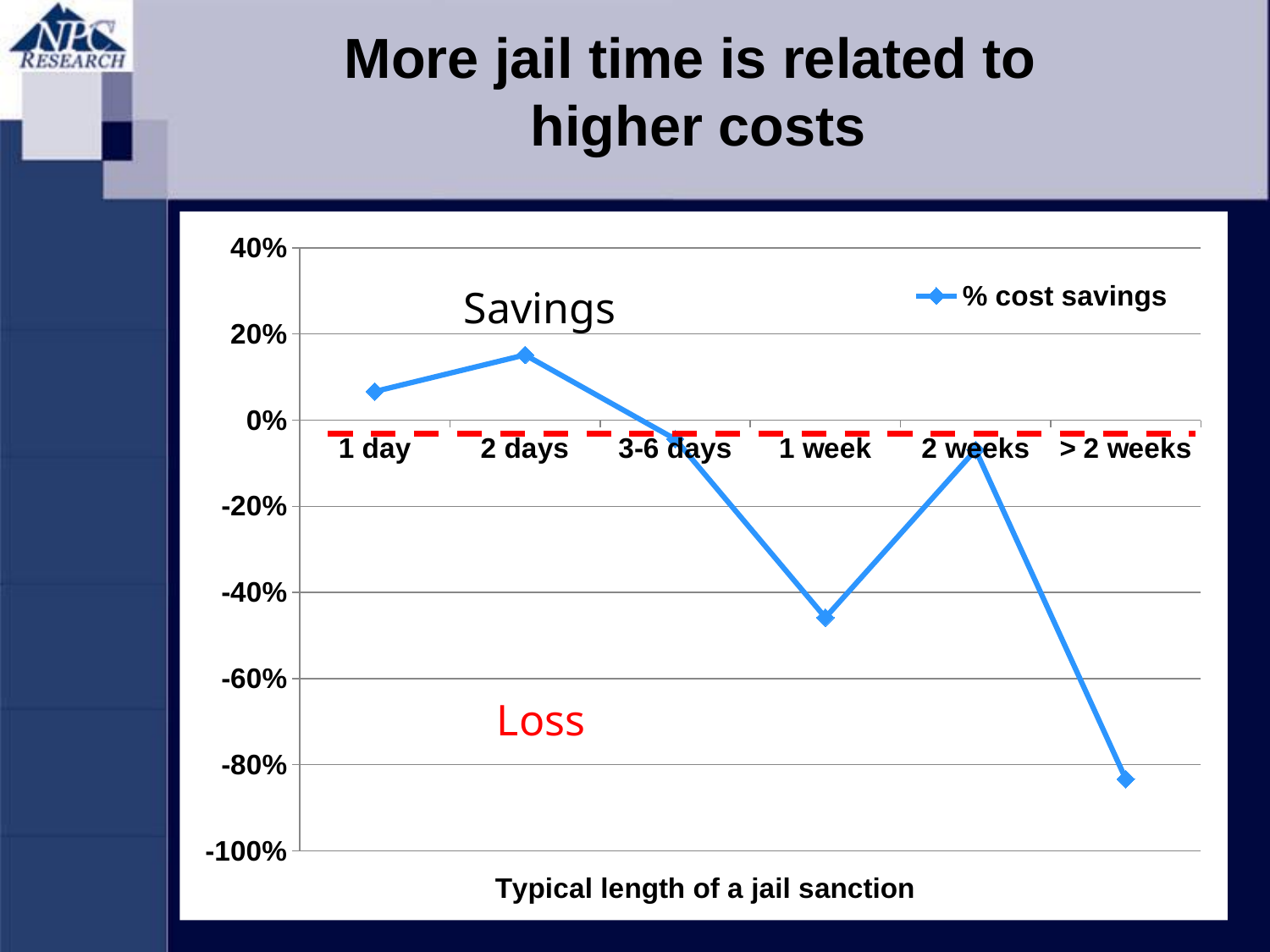
What is the title of the x axis? Typical length of a jail sanction Which jail sanction length has the highest % cost savings? 2 days How many jail sanction length categories are plotted on the x axis? 6 What kind of chart is shown on the slide? line chart Is the % cost savings value for 1 week greater or less than -40%? less How many series does the legend list? 1 Is the % cost savings value for > 2 weeks greater or less than -60%? less Which has a higher % cost savings value, 1 week or 2 weeks? 2 weeks Is the % cost savings value for 2 weeks greater or less than 0%? less Overall, do the % cost savings values rise or fall as the jail sanction length increases along the x axis? fall Which jail sanction length has the lowest % cost savings? > 2 weeks